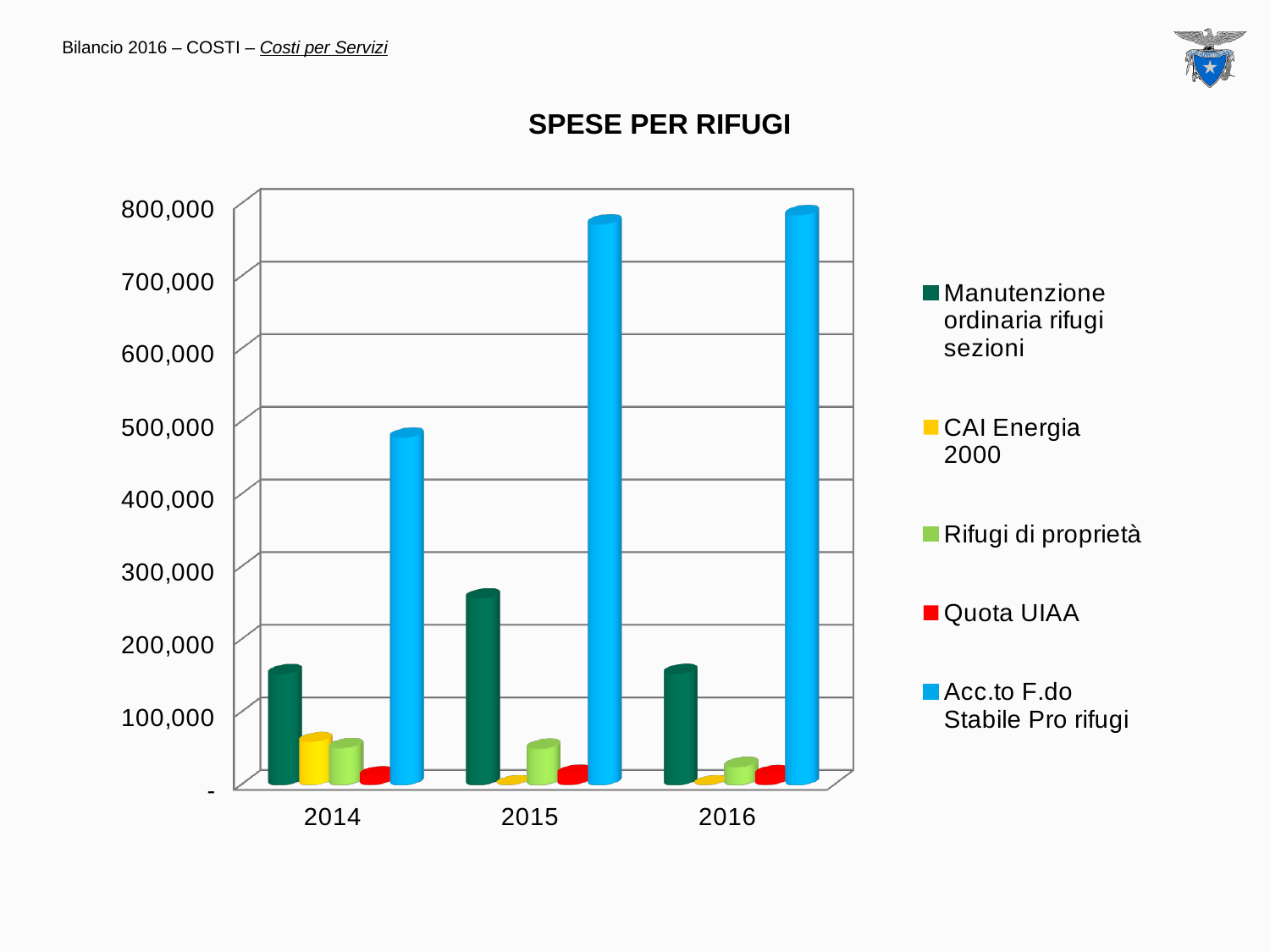
Is the value for Acc.to F.do Stabile Pro rifugi in 2015 greater or less than 700,000? greater Which colour represents Quota UIAA in the chart? red What kind of chart is shown on the slide? bar chart Is the value for Manutenzione ordinaria rifugi sezioni in 2015 greater or less than 200,000? greater Which series has the highest value in 2016? Acc.to F.do Stabile Pro rifugi Which is larger: Manutenzione ordinaria rifugi sezioni in 2015 or in 2016? 2015 What is the title of the chart? SPESE PER RIFUGI How many series does the legend of the chart list? 5 Does the value for Acc.to F.do Stabile Pro rifugi rise or fall from 2014 to 2016? rise Is the value for Manutenzione ordinaria rifugi sezioni in 2014 greater or less than 200,000? less How many years are shown on the x axis of the chart? 3